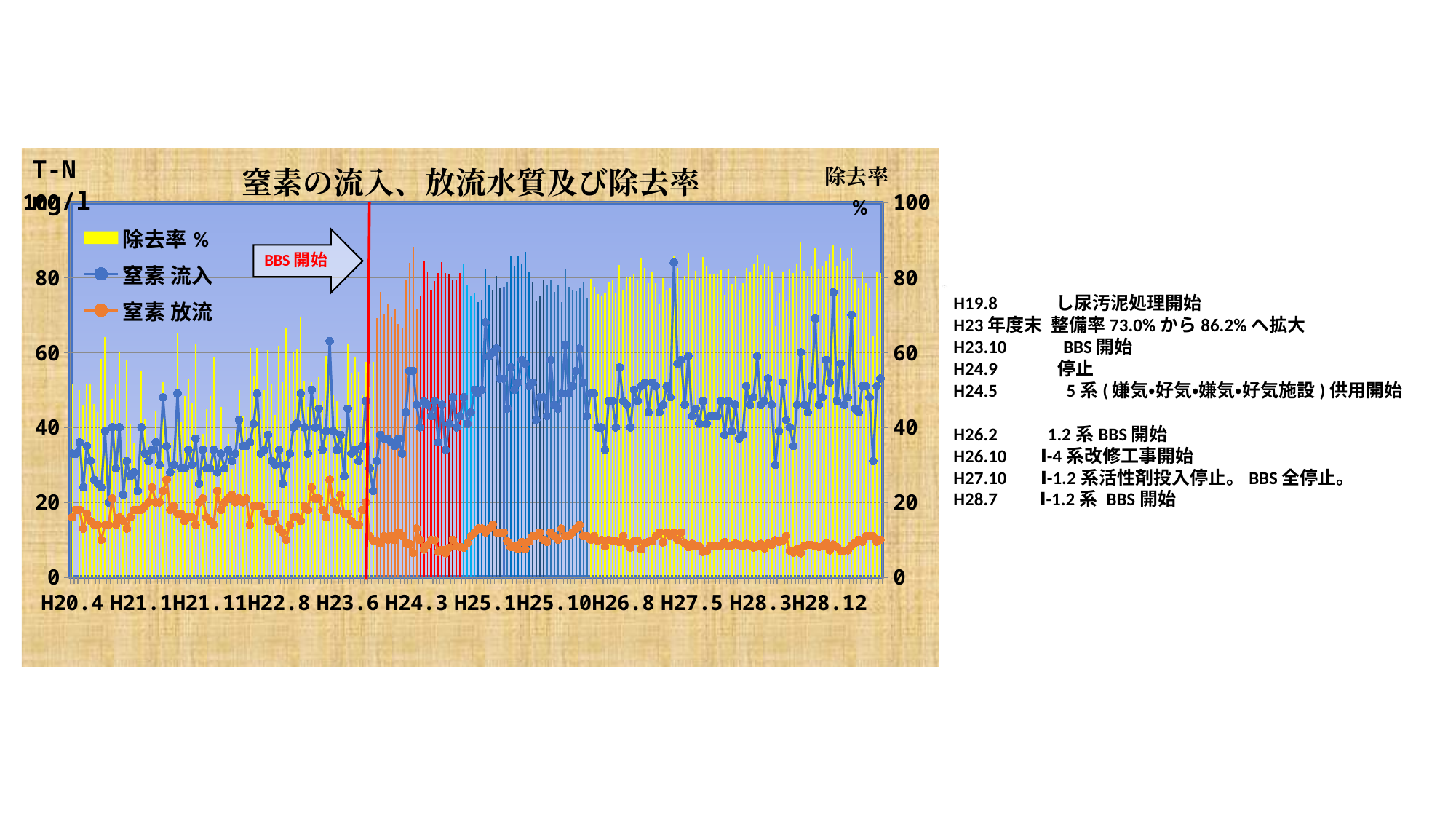
Is the value for 窒素 放流 at H20.4 greater or less than 40? less Does the 窒素 放流 line generally rise or fall from H20.4 to H28.12? fall Which line series stays higher throughout the chart, 窒素 流入 or 窒素 放流? 窒素 流入 At H20.4, which series has the larger value, 窒素 流入 or 窒素 放流? 窒素 流入 How many series does the chart legend list? 3 Which series is drawn as yellow bars in the chart? 除去率 % What kind of chart is shown on the slide? A combined bar and line chart Is the value for 窒素 放流 at H28.12 greater or less than 20? less Is the value for 窒素 流入 at H20.4 greater or less than 20? greater How many labels are shown on the x axis of the chart? 12 What is the title of the chart? 窒素の流入、放流水質及び除去率